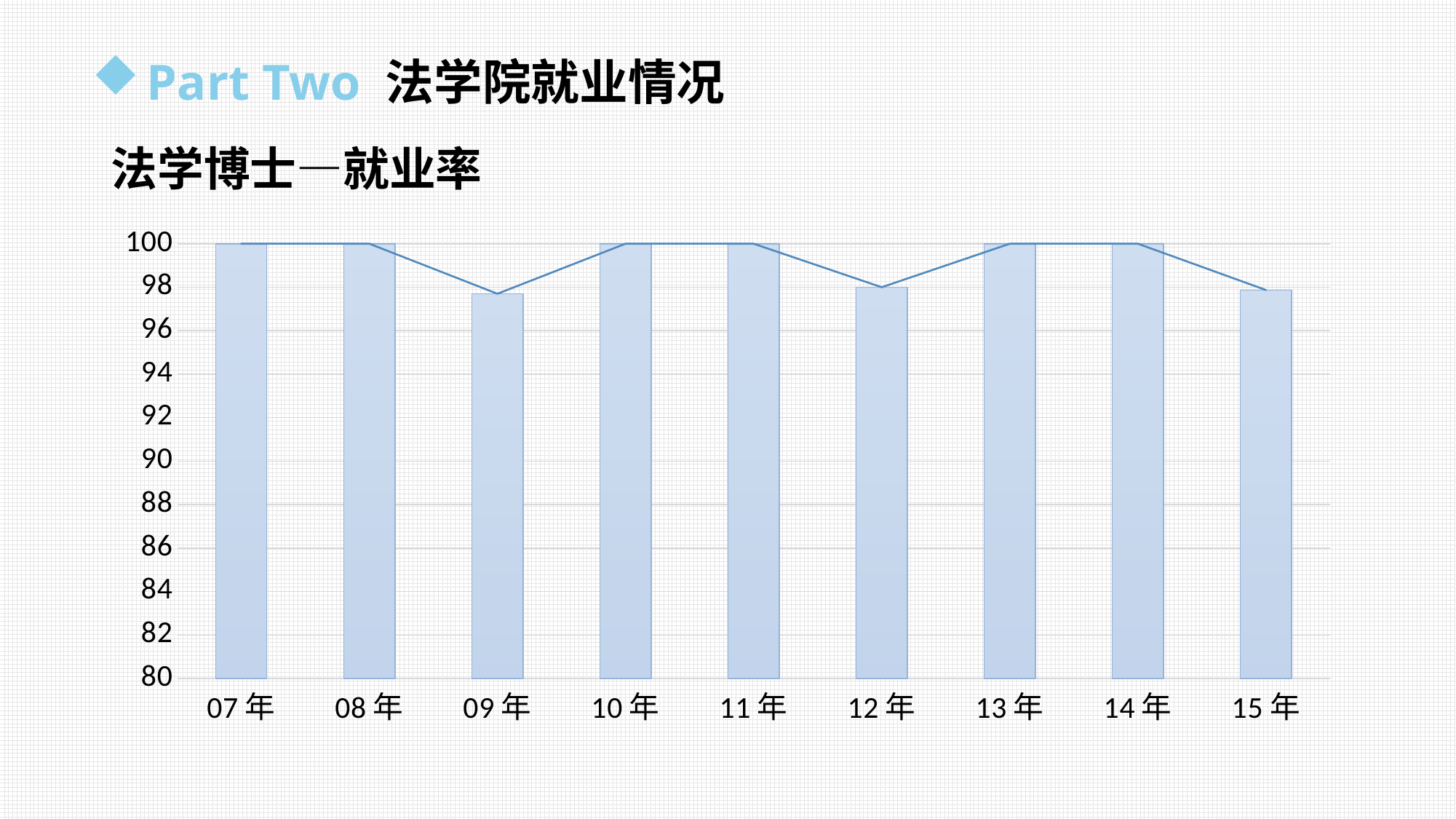
Do the values rise or fall from 14年 to 15年? fall What kind of chart is shown on the slide? combination bar and line chart How many years are shown on the x axis? 9 Which is larger, the value for 07年 or the value for 09年? 07年 Is the value for 15年 greater or less than 96? greater What is the value for 13年? 100 Is the value for 12年 greater or less than 100? less Is the value for 09年 greater or less than 96? greater Do the values rise or fall from 09年 to 10年? rise Which is larger, the value for 12年 or the value for 13年? 13年 What is the title of the chart? 法学博士—就业率 What is the value for 07年? 100